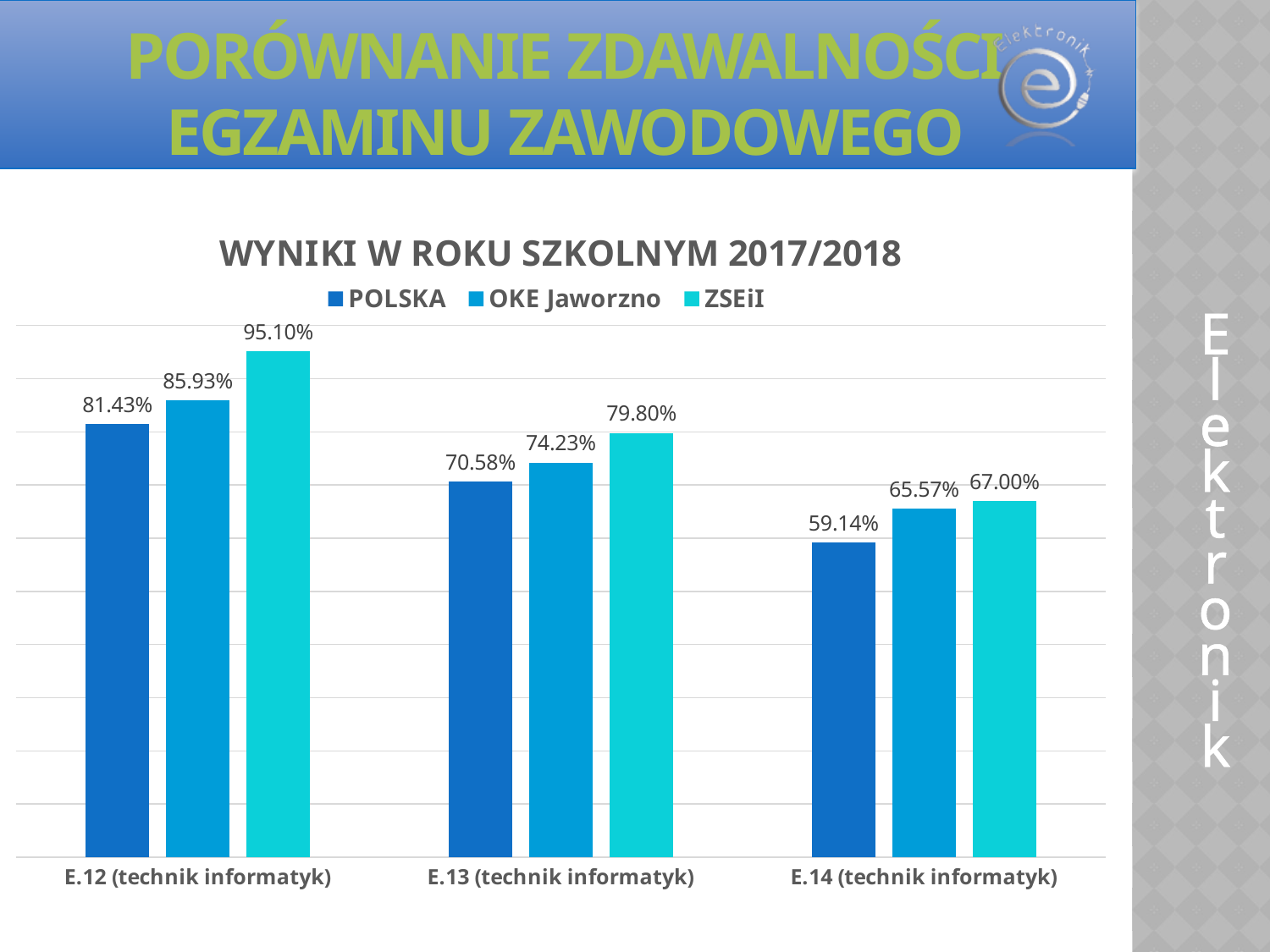
What kind of chart is shown? Bar chart How many categories are shown on the x axis? 3 What is the OKE Jaworzno value for E.13 (technik informatyk)? 74.23% What is the POLSKA value for E.14 (technik informatyk)? 59.14% How many series does the legend list? 3 Which category has the highest ZSEiI value? E.12 (technik informatyk) Which is larger for E.13 (technik informatyk): the ZSEiI value or the OKE Jaworzno value? ZSEiI What is the ZSEiI value for E.12 (technik informatyk)? 95.10% Do the POLSKA values rise or fall from E.12 to E.14? Fall Which category has the lowest POLSKA value? E.14 (technik informatyk) What is the difference between the ZSEiI and POLSKA values for E.12 (technik informatyk)? 13.67% What is the difference between the OKE Jaworzno and POLSKA values for E.14 (technik informatyk)? 6.43%